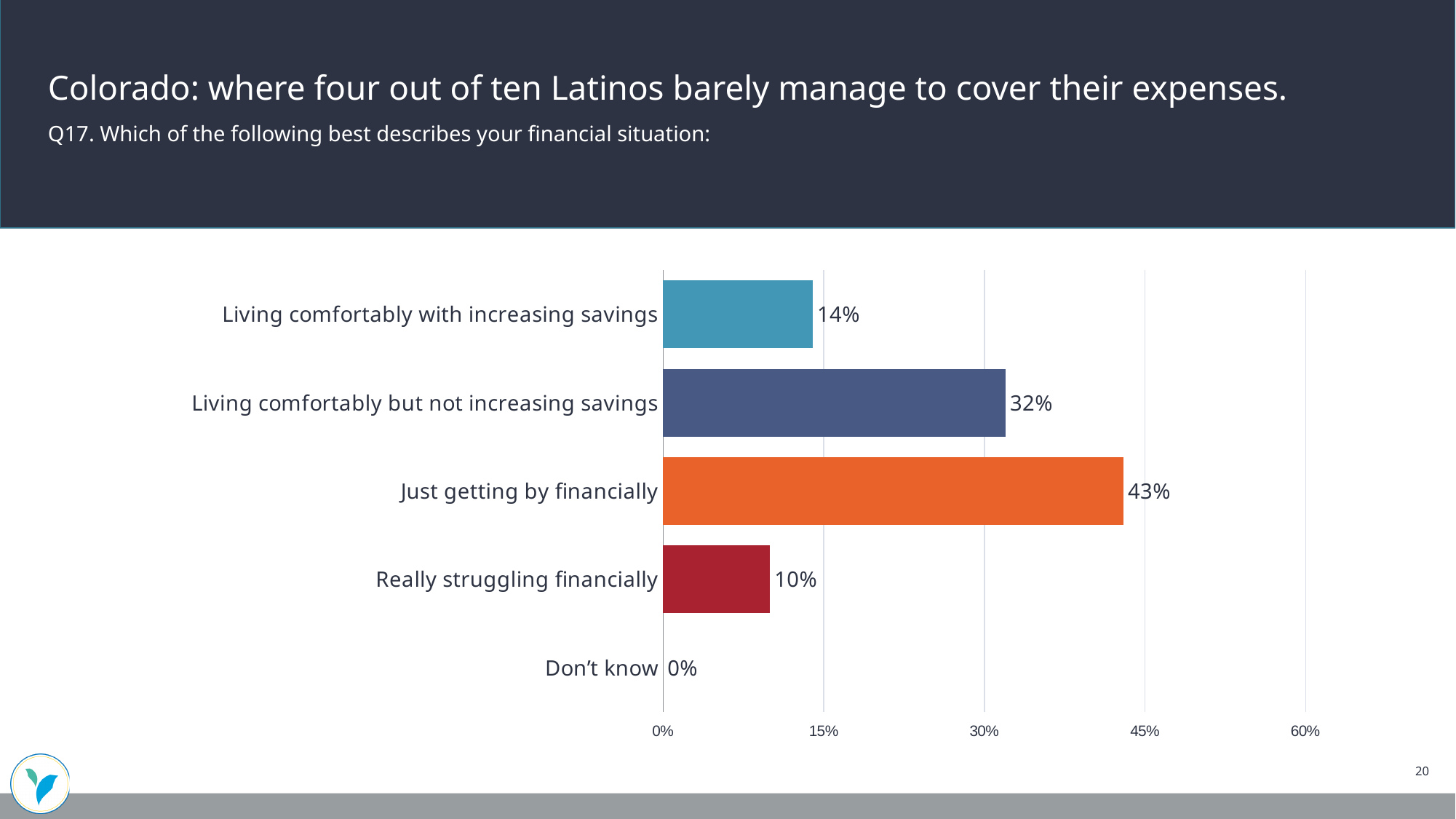
What is the value for 'Don't know'? 0% Which category has the lowest value? Don't know Which category has the highest value? Just getting by financially Is the value for 'Living comfortably but not increasing savings' greater or less than 30%? greater What is the value for 'Really struggling financially'? 10% What is the value for 'Living comfortably with increasing savings'? 14% Which is larger: 'Living comfortably with increasing savings' or 'Really struggling financially'? Living comfortably with increasing savings What percentage of respondents are 'Just getting by financially'? 43% How many categories are shown in the chart? 5 What is the difference between 'Just getting by financially' and 'Living comfortably but not increasing savings'? 11% What kind of chart is shown on the slide? Bar chart What is the highest value shown on the x axis? 60%